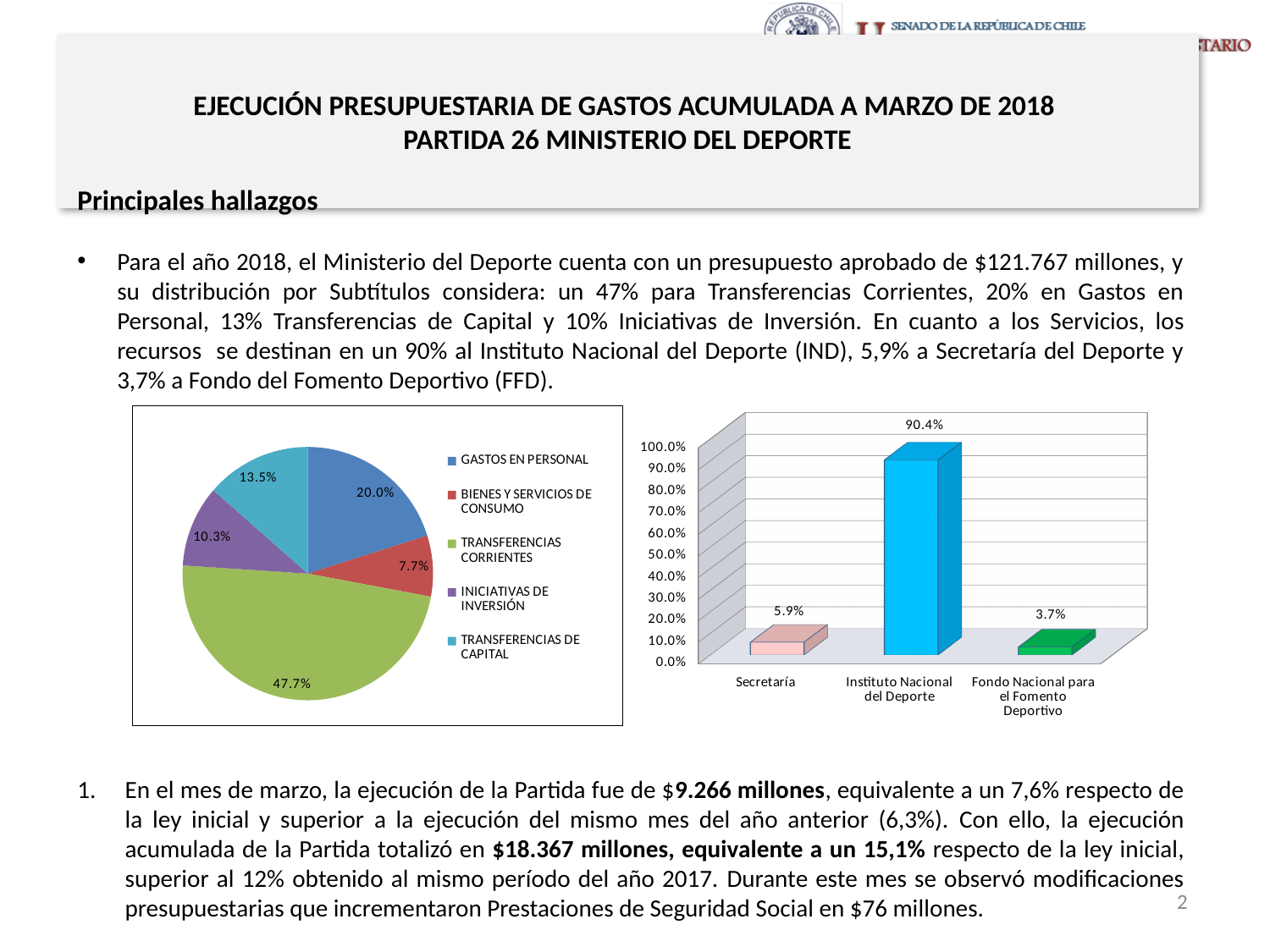
In the pie chart on the left, what is the difference between the shares for TRANSFERENCIAS DE CAPITAL and INICIATIVAS DE INVERSIÓN? 3.2% In the pie chart on the left, which category has the largest slice? TRANSFERENCIAS CORRIENTES What kind of chart is shown on the right side of the slide? Bar chart In the bar chart on the right, what is the value for Instituto Nacional del Deporte? 90.4% In the bar chart on the right, what is the value for Secretaría? 5.9% In the pie chart on the left, how many categories does the legend list? 5 In the pie chart on the left, what share is labelled for TRANSFERENCIAS CORRIENTES? 47.7% In the pie chart on the left, which category has the smallest slice? BIENES Y SERVICIOS DE CONSUMO In the bar chart on the right, what is the difference between the values for Secretaría and Fondo Nacional para el Fomento Deportivo? 2.2% In the pie chart on the left, what share is labelled for GASTOS EN PERSONAL? 20.0% In the pie chart on the left, which is larger: the share for INICIATIVAS DE INVERSIÓN or the share for BIENES Y SERVICIOS DE CONSUMO? INICIATIVAS DE INVERSIÓN In the bar chart on the right, which category has the lowest value? Fondo Nacional para el Fomento Deportivo